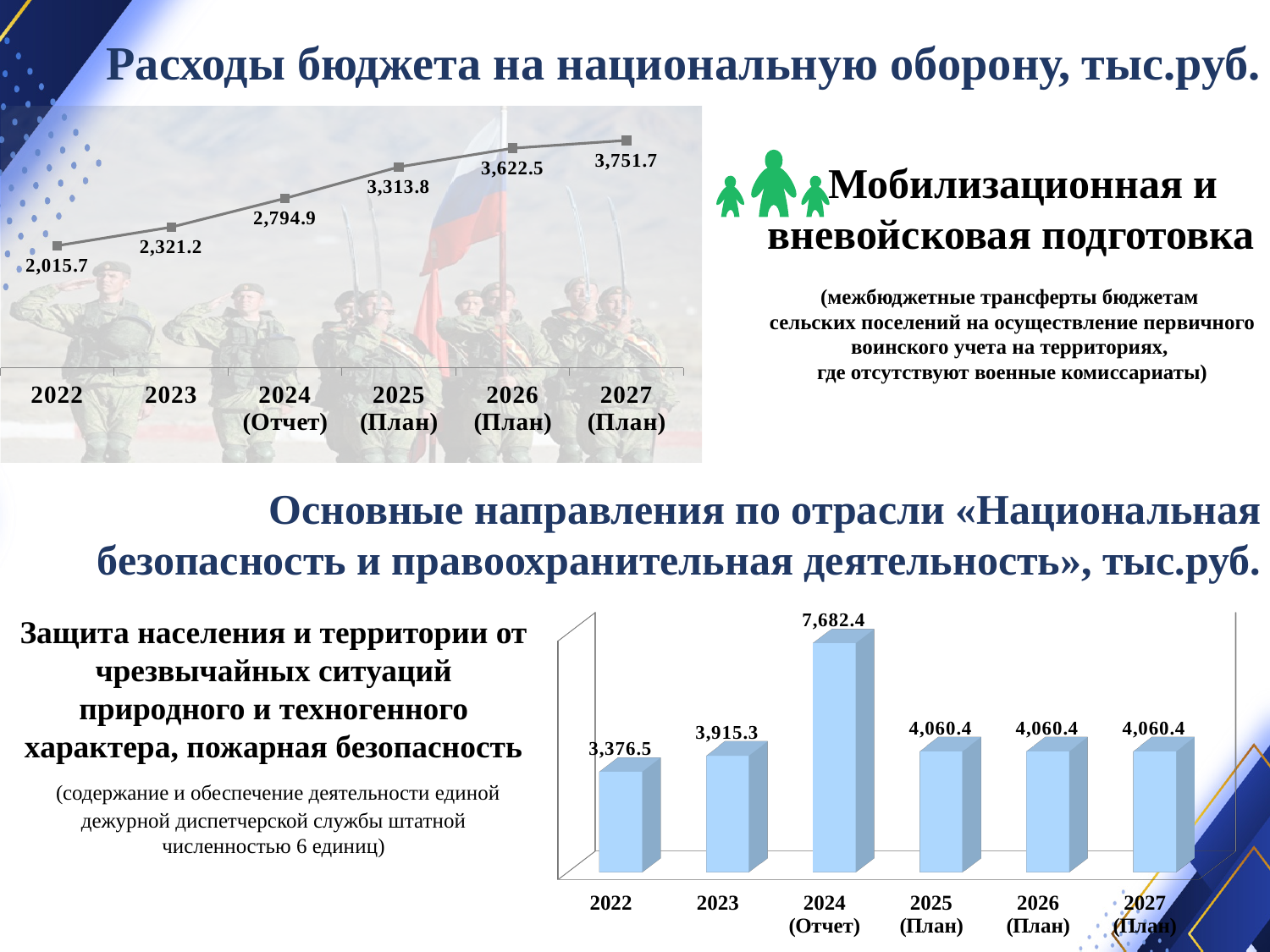
How many data points are plotted in the top line chart on national defence expenditures? 6 In the top line chart on national defence expenditures, what is the value for 2022? 2,015.7 In the top line chart on national defence expenditures, what is the difference between the 2027 (План) value and the 2026 (План) value? 129.2 What type of chart is the bottom chart on national security and law enforcement? bar chart What type of chart is the top chart on national defence expenditures? line chart In the bottom bar chart on national security and law enforcement, which is larger: the value for 2023 or the value for 2025 (План)? 2025 (План) In the bottom bar chart on national security and law enforcement, what is the difference between the 2024 (Отчет) value and the 2025 (План) value? 3,622.0 In the top line chart on national defence expenditures, which year has the highest value? 2027 (План) In the top line chart on national defence expenditures, what is the value for 2025 (План)? 3,313.8 In the bottom bar chart on national security and law enforcement, which year has the lowest value? 2022 In the bottom bar chart on national security and law enforcement, what is the value for 2024 (Отчет)? 7,682.4 In the top line chart on national defence expenditures, do the values rise or fall from 2022 to 2027? rise